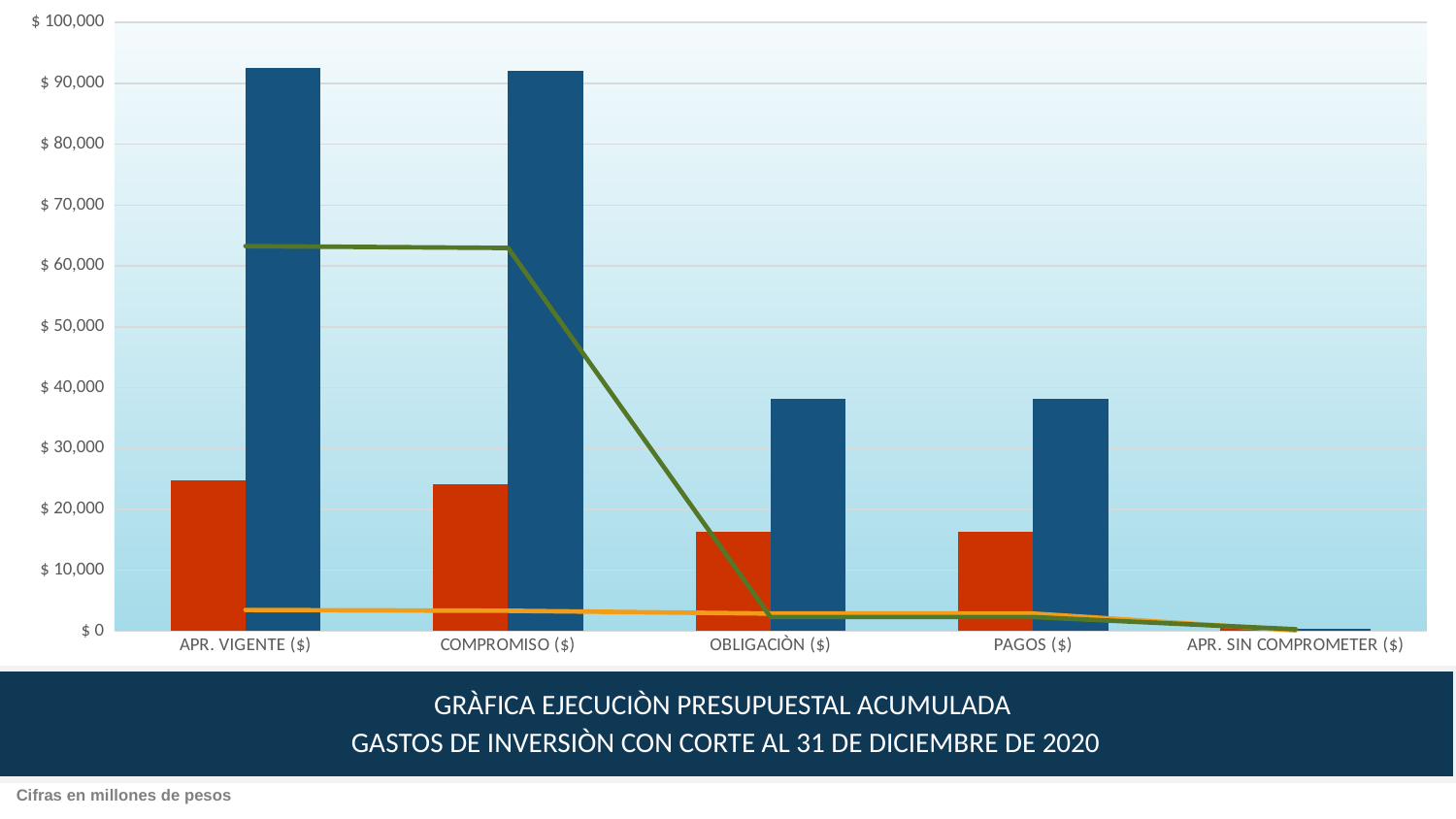
Is the value of the green line at COMPROMISO ($) greater or less than $ 60,000? greater Is the value of the blue bar for APR. VIGENTE ($) greater or less than $ 90,000? greater What kind of chart is shown on the slide? bar and line chart Does the green line rise or fall from COMPROMISO ($) to OBLIGACIÒN ($)? fall For OBLIGACIÒN ($), which bar is taller, the blue bar or the orange bar? the blue bar What is the highest value shown on the y axis of the chart? $ 100,000 Is the value of the orange bar for APR. VIGENTE ($) greater or less than $ 20,000? greater Which category has the lowest blue bar? APR. SIN COMPROMETER ($) Which blue bar is taller, APR. VIGENTE ($) or PAGOS ($)? APR. VIGENTE ($) How many categories are shown on the x axis of the chart? 5